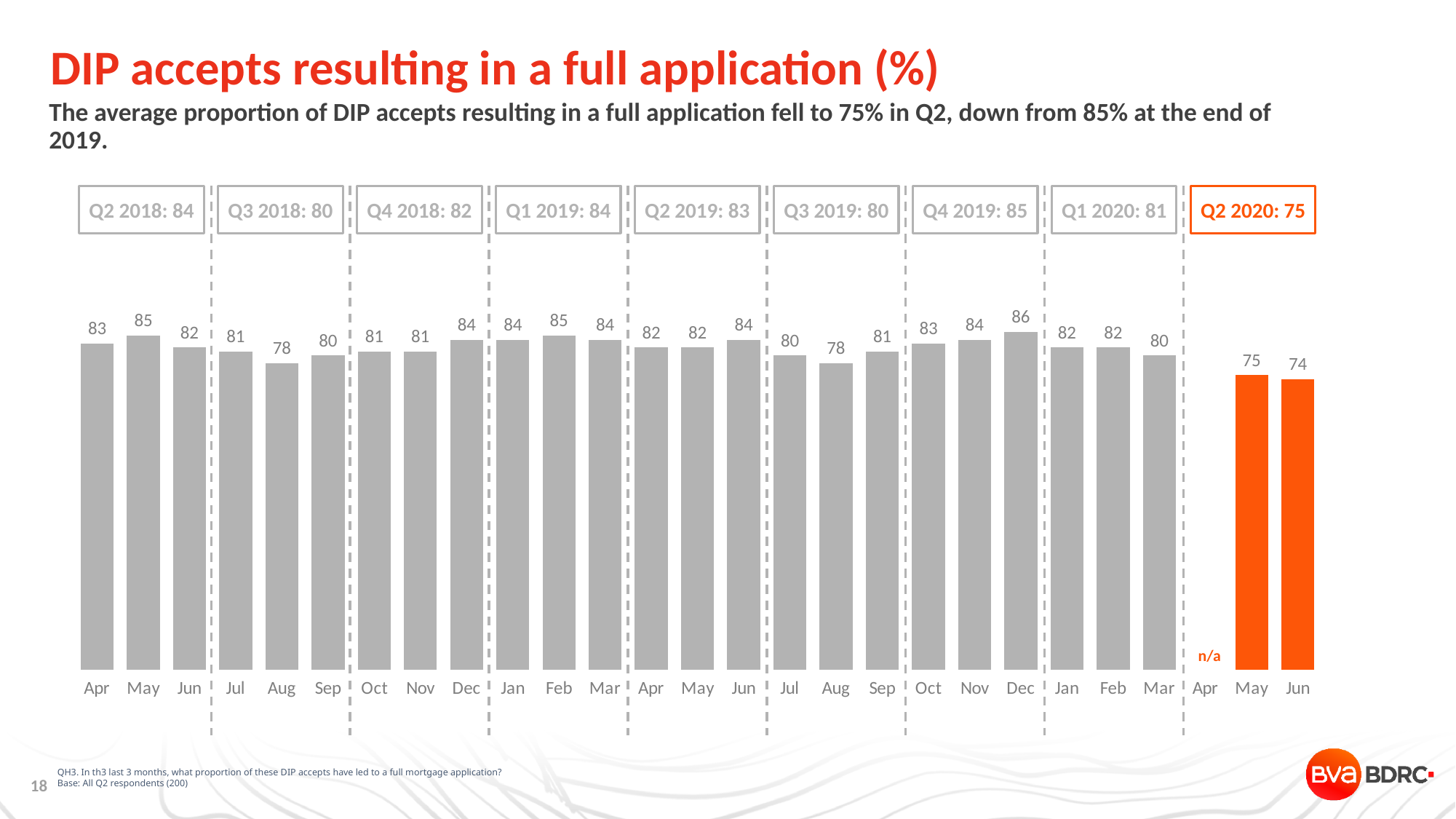
Which month has the lowest value on the chart? Jun (Q2 2020) What is the quarterly average shown for Q2 2020? 75 What is the value for Jun in Q2 2020? 74 What kind of chart is shown on the slide? Bar chart What is the value for Aug in Q3 2018? 78 What is the quarterly average shown for Q4 2019? 85 Which month has the highest value on the chart? Dec (Q4 2019) What is the difference between the value for Dec in Q4 2019 and the value for Jun in Q2 2020? 12 How many months are labelled on the x axis? 27 What is the value for Dec in Q4 2019? 86 What is shown for Apr in Q2 2020? n/a Which is larger, the value for May in Q2 2018 or the value for May in Q2 2020? May in Q2 2018